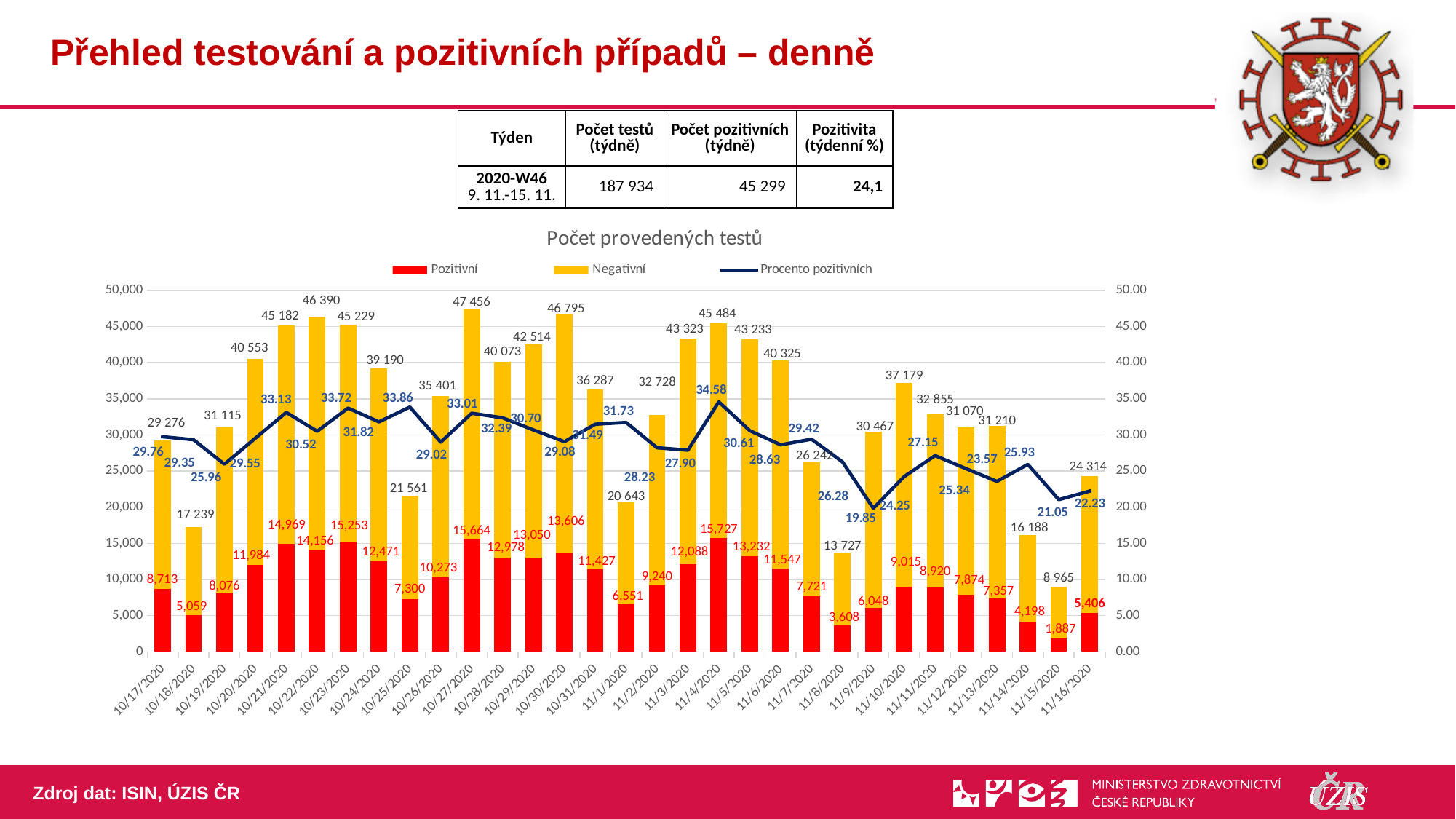
How many series does the chart legend list? 3 On which date is the total number of tests performed the highest? 10/27/2020 What kind of chart is 'Počet provedených testů'? Stacked bar chart with a line On which date is the percentage of positive tests the lowest? 11/9/2020 Which date has more positive tests, 10/23/2020 or 11/4/2020? 11/4/2020 What is the total number of tests performed on 10/27/2020? 47 456 What is the difference between the total tests on 10/27/2020 and 10/26/2020? 12 055 How many dates are shown on the x axis of the chart? 31 What is the number of positive tests (Pozitivní) on 10/21/2020? 14,969 On which date is the total number of tests performed the lowest? 11/15/2020 What is the percentage of positive tests (Procento pozitivních) on 11/4/2020? 34.58 Does the percentage of positive tests rise or fall from 11/4/2020 to 11/9/2020? Fall